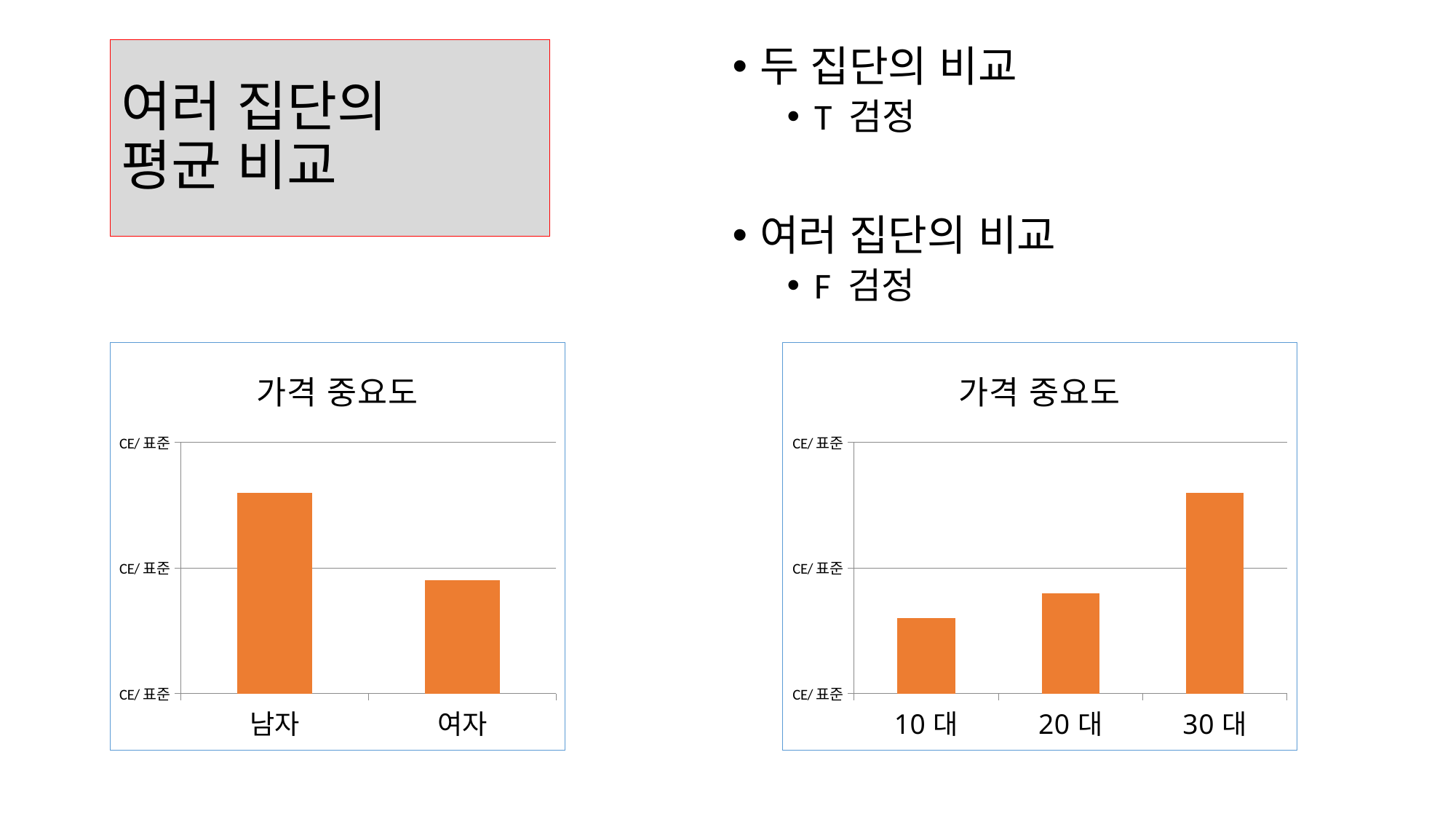
What is the title of the right chart? 가격 중요도 In the left chart, is the bar for 남자 taller or shorter than the bar for 여자? taller In the left chart, which category has the higher bar? 남자 In the right chart, is the bar for 20 대 taller or shorter than the bar for 10 대? taller In the left chart, which category has the lower bar? 여자 In the right chart, which age group has the highest bar? 30 대 What kind of chart is the right chart on the slide? bar chart In the right chart, do the bars rise or fall from 10 대 to 30 대? rise What kind of chart is the left chart on the slide? bar chart In the right chart, which age group has the lowest bar? 10 대 In the right chart, how many categories are shown on the x axis? 3 In the left chart, how many categories are shown on the x axis? 2